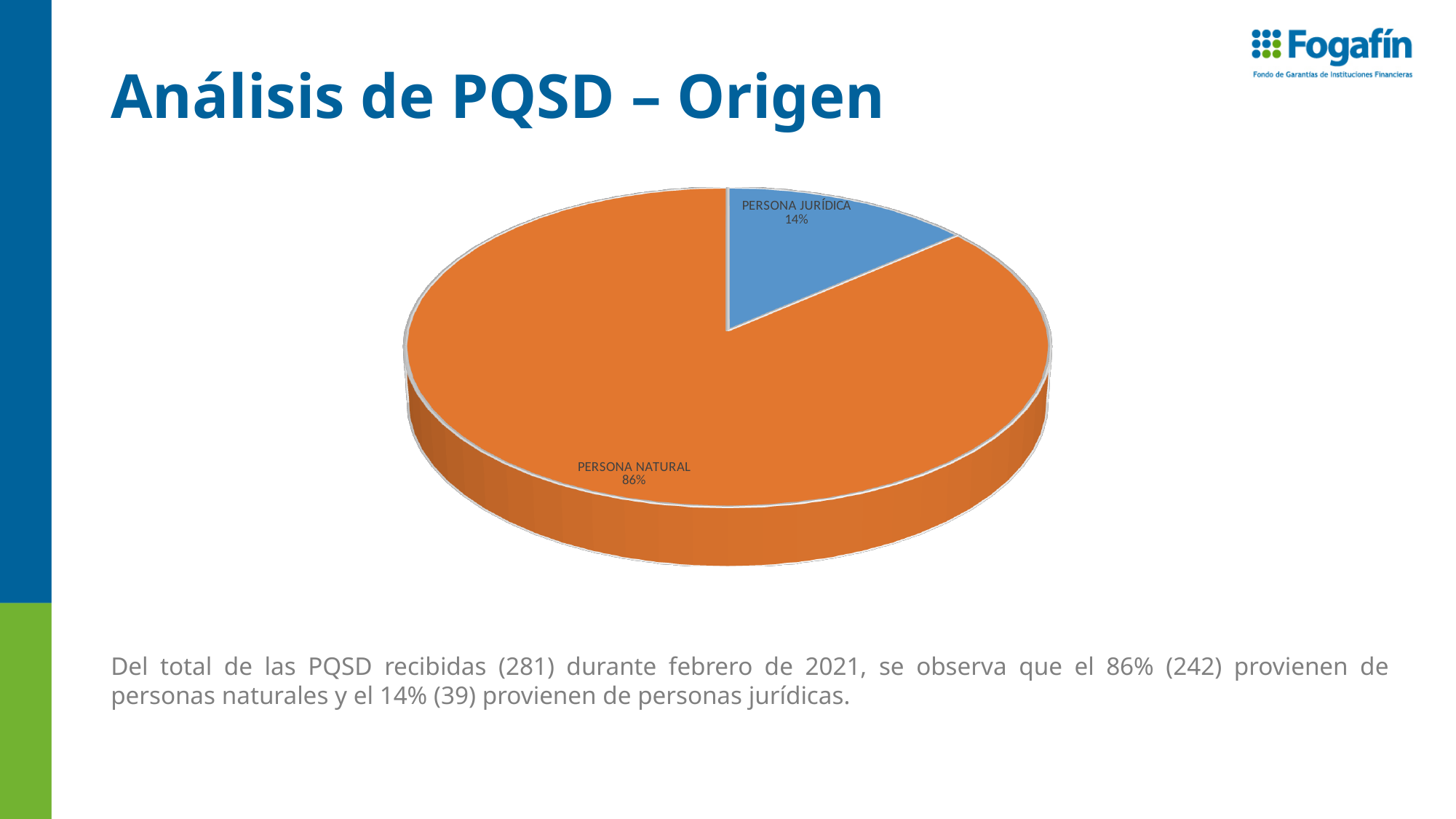
What share of the pie does PERSONA NATURAL represent? 86% How many categories are shown in the pie chart? 2 What is the difference in percentage points between the PERSONA NATURAL and PERSONA JURÍDICA slices? 72 What share of the pie does PERSONA JURÍDICA represent? 14% Which category has the largest slice of the pie? PERSONA NATURAL Which category has the smallest slice of the pie? PERSONA JURÍDICA Which slice is larger, PERSONA NATURAL or PERSONA JURÍDICA? PERSONA NATURAL What colour is the PERSONA NATURAL slice? Orange What colour is the PERSONA JURÍDICA slice? Blue What kind of chart is shown on the slide? Pie chart